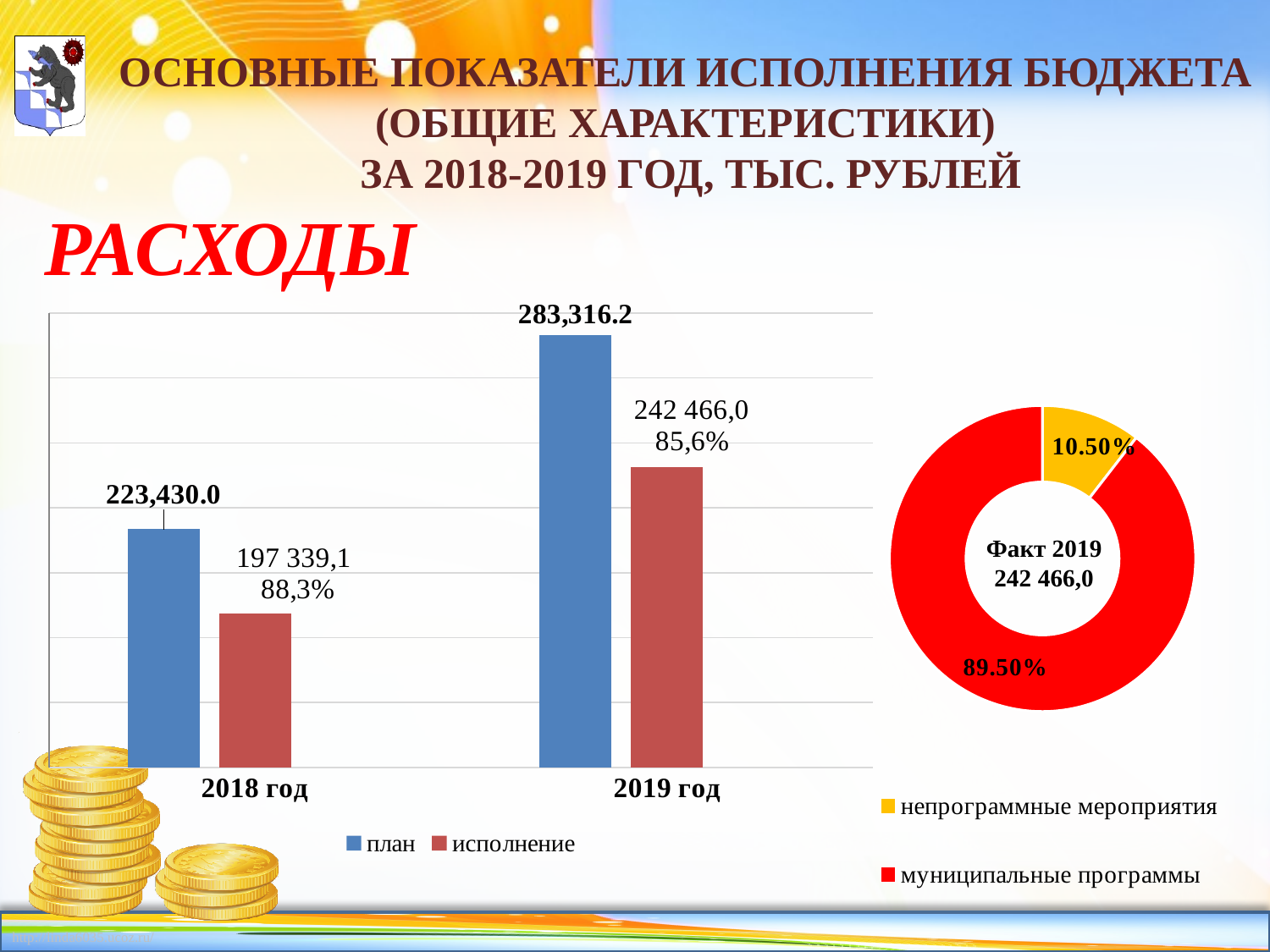
On the bar chart, what is the value of план for 2019 год? 283,316.2 On the doughnut chart, what share is shown for муниципальные программы? 89.50% On the bar chart, what is the difference between the план values for 2019 год and 2018 год? 59,886.2 On the bar chart, what is the value of исполнение for 2018 год? 197 339,1 On the bar chart, what is the value of план for 2018 год? 223,430.0 On the bar chart, do the план values rise or fall from 2018 год to 2019 год? rise On the bar chart, how many series does the legend list? 2 On the bar chart, what percentage is shown next to the исполнение bar for 2018 год? 88,3% On the doughnut chart, what share is shown for непрограммные мероприятия? 10.50% On the bar chart, what is the value of исполнение for 2019 год? 242 466,0 What type of chart is the one on the left of the slide? bar chart On the bar chart, which year has the higher план value? 2019 год